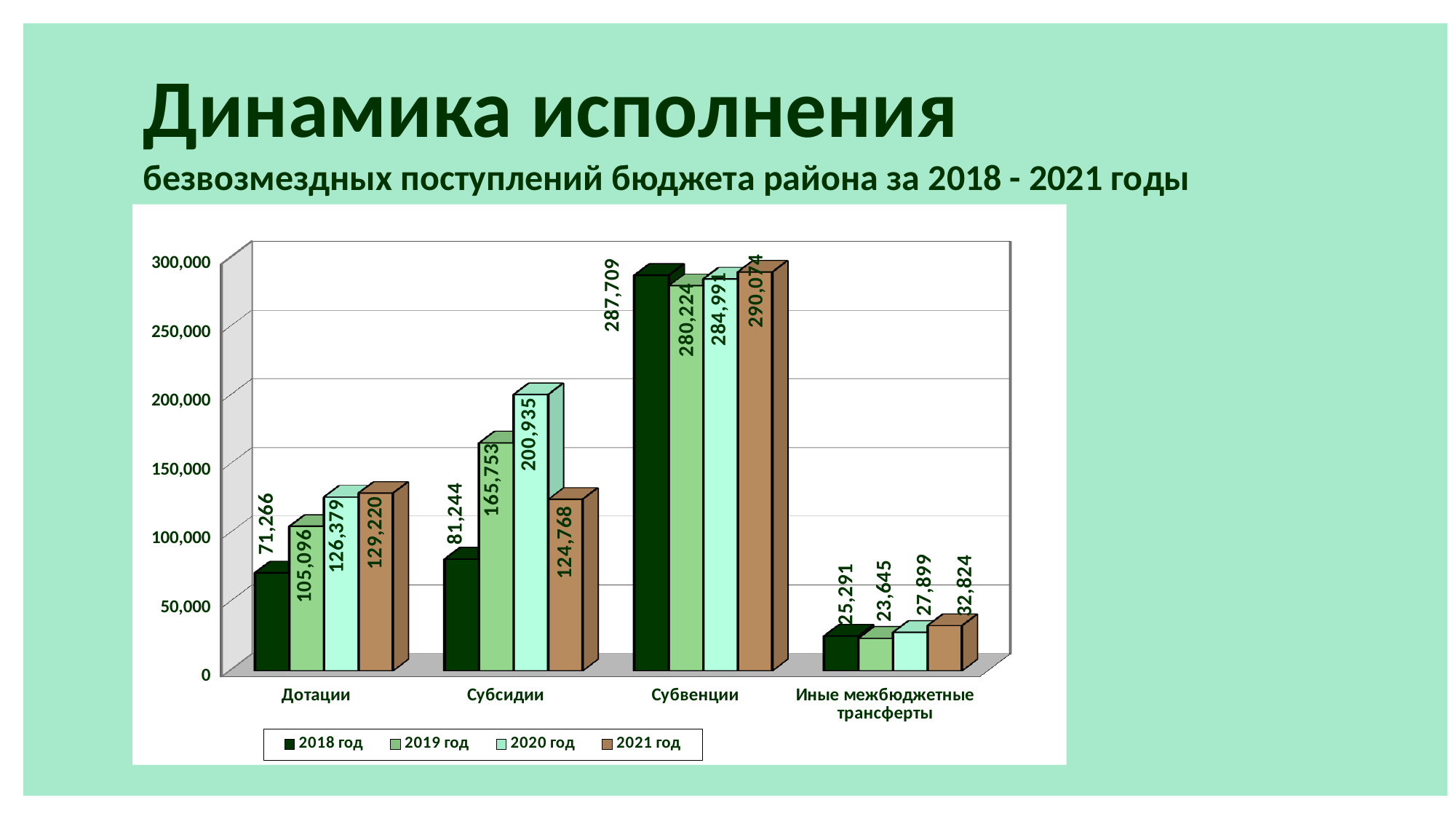
Do the values for Дотации rise or fall from 2018 год to 2021 год? Rise What is the value for Субсидии in 2020 год? 200,935 Which category has the lowest value in 2021 год? Иные межбюджетные трансферты Which category has the highest value in 2018 год? Субвенции What is the difference between the 2021 год and 2018 год values for Дотации? 57,954 What is the value for Иные межбюджетные трансферты in 2021 год? 32,824 How many categories are shown on the x axis? 4 What kind of chart is shown on the slide? Bar chart Which is larger for Субсидии: the 2019 год value or the 2021 год value? 2019 год What is the value for Дотации in 2018 год? 71,266 What is the value for Субвенции in 2019 год? 280,224 How many series does the legend list? 4